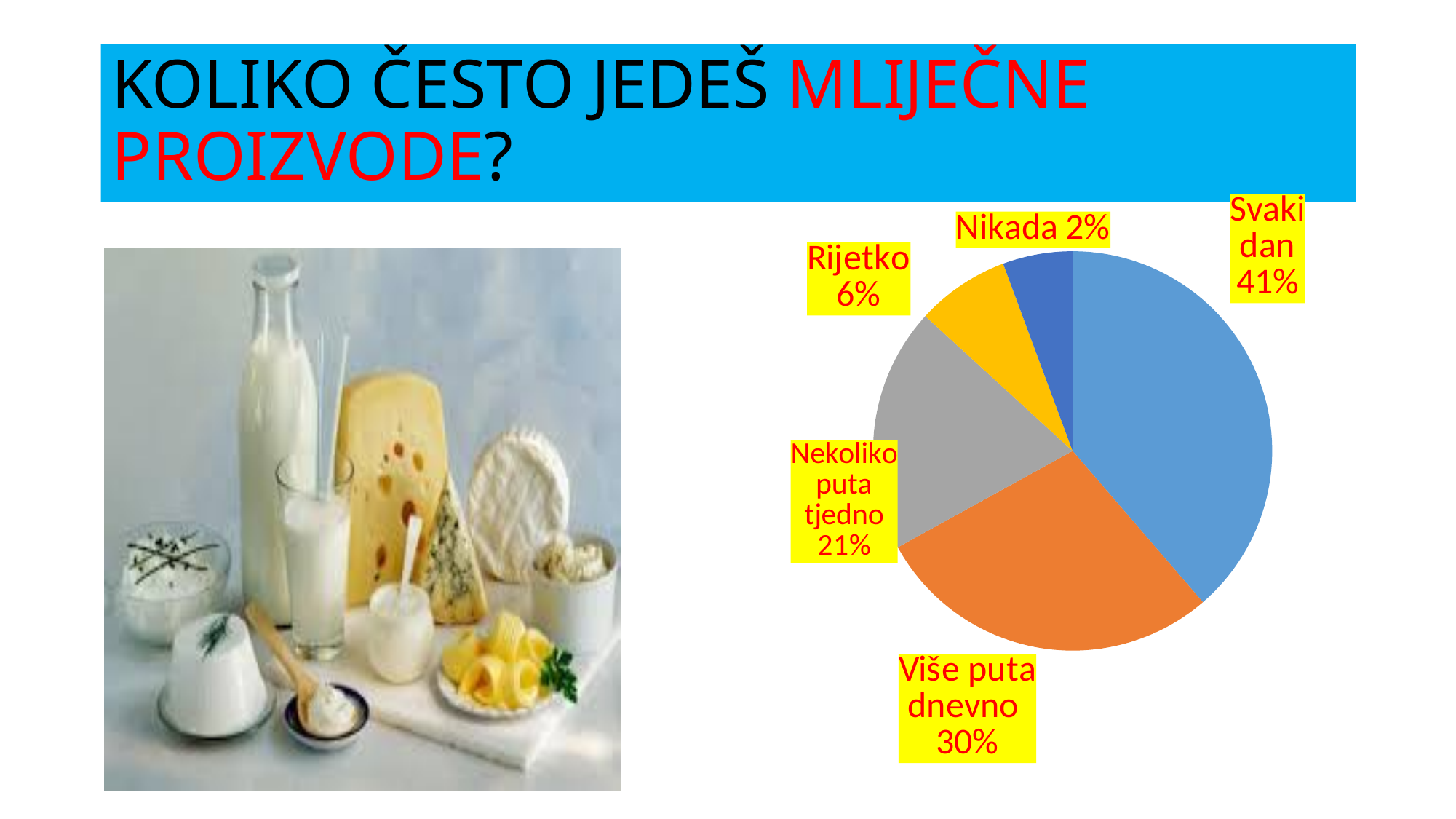
Which is larger, the value for "Nekoliko puta tjedno" or the value for "Rijetko"? Nekoliko puta tjedno What is the value for "Nekoliko puta tjedno"? 21% What share of the pie does "Svaki dan" have? 41% What is the difference between the values for "Svaki dan" and "Više puta dnevno"? 11% What is the value for "Rijetko"? 6% Which category has the largest slice of the pie? Svaki dan Which category has the smallest slice of the pie? Nikada What is the value for "Nikada"? 2% What kind of chart is shown on the slide? pie chart What colour is the "Više puta dnevno" slice? orange How many categories does the pie chart show? 5 What is the value for "Više puta dnevno"? 30%